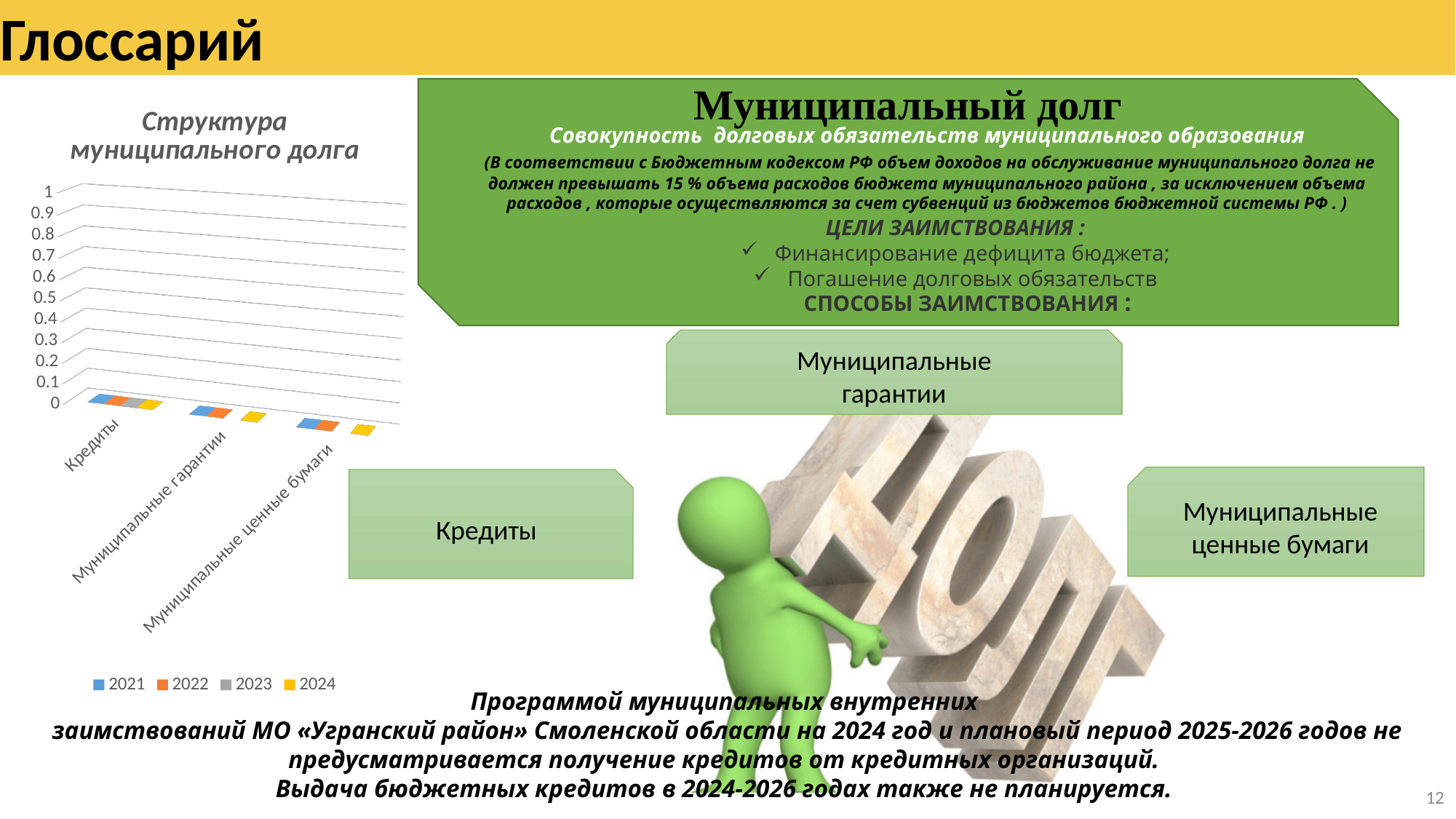
Is the value for Кредиты in 2024 greater or less than 0.1? less Is the value for Муниципальные ценные бумаги in 2024 greater or less than 0.5? less What is the highest tick value shown on the vertical axis of the chart? 1 Is the value for Муниципальные гарантии in 2022 greater or less than 0.5? less How many series does the chart's legend list? 4 Which years are listed in the chart's legend? 2021, 2022, 2023, 2024 What kind of chart is shown on the slide? bar chart How many categories are shown on the x axis of the chart? 3 What is the title of the chart on the slide? Структура муниципального долга